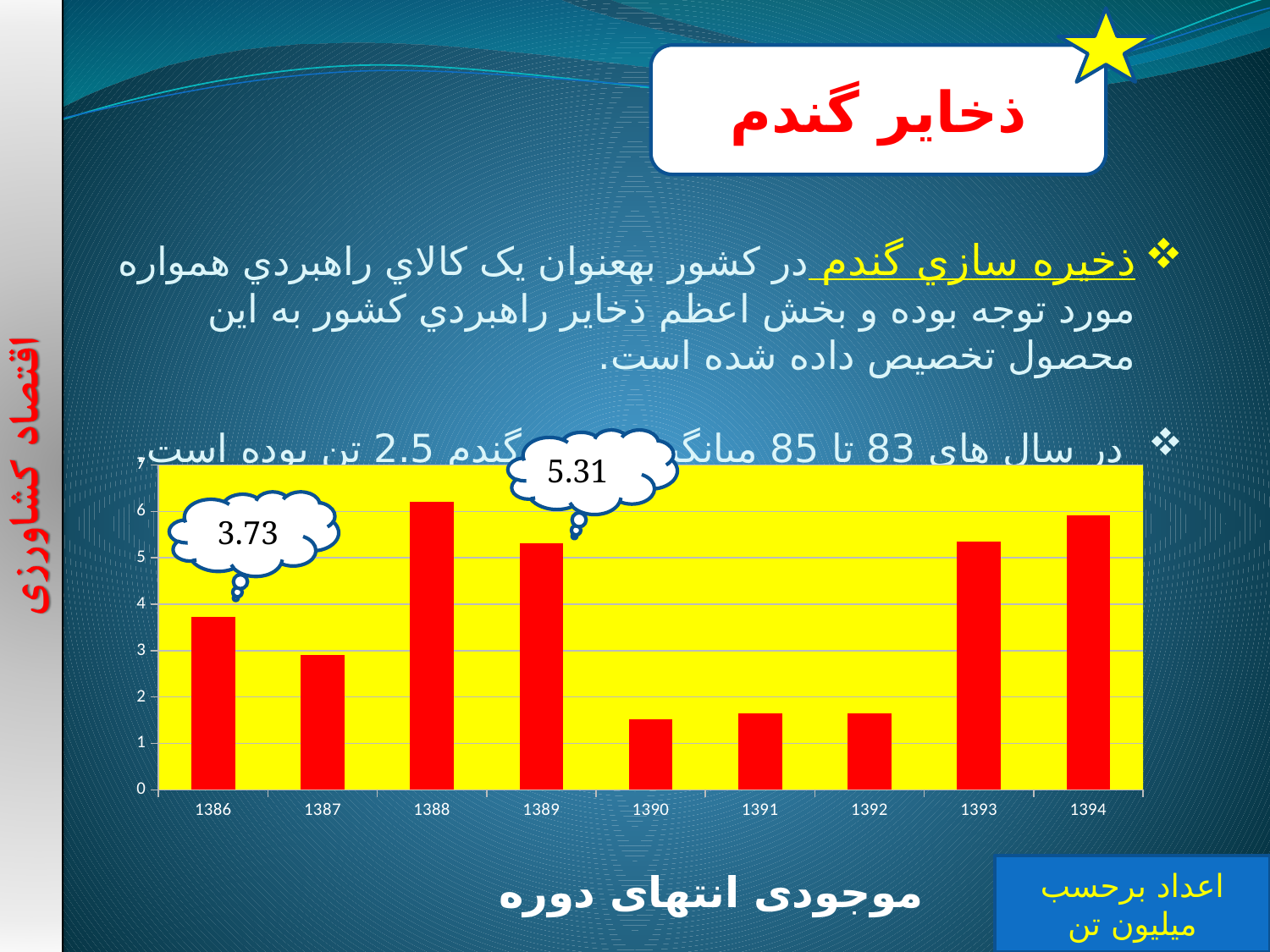
What is the value for 1389? 5.31 Is the value for 1390 greater or less than 2? less Which is larger, the value for 1388 or the value for 1389? 1388 What kind of chart is shown? bar chart Which year has the highest bar? 1388 What is the value for 1386? 3.73 Which is larger, the value for 1387 or the value for 1390? 1387 What colour are the bars? red Is the value for 1394 greater or less than 5? greater How many years are shown on the x axis? 9 Is the value for 1387 greater or less than 3? less What is the difference between the values for 1389 and 1386? 1.58